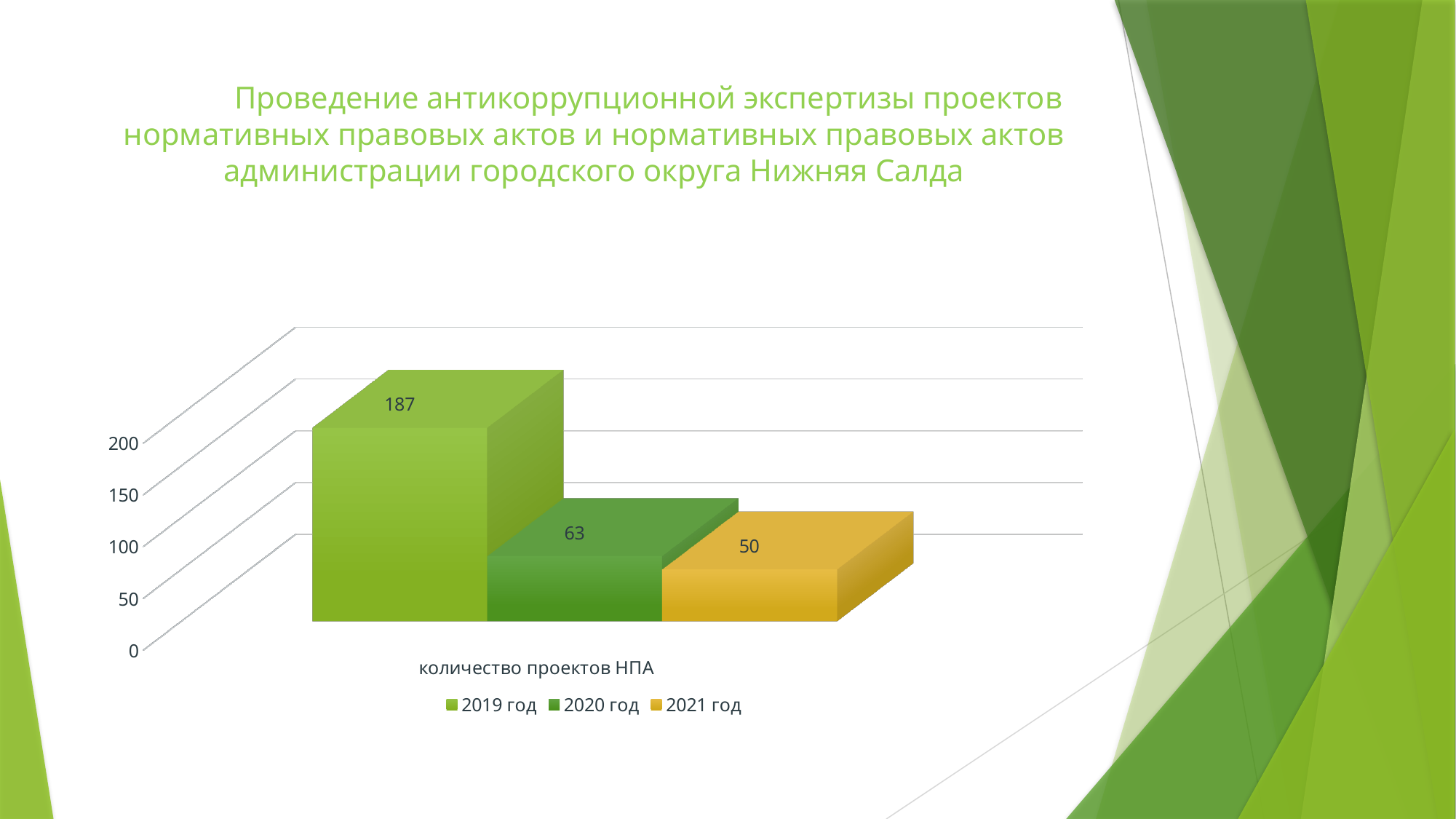
What is the difference between the values for 2020 год and 2021 год? 13 What is the value for 2021 год (количество проектов НПА)? 50 Is the value for 2019 год greater or less than 150? greater What is the value for 2020 год (количество проектов НПА)? 63 What is the difference between the values for 2019 год and 2020 год? 124 How many series does the legend list? 3 What is the value for 2019 год (количество проектов НПА)? 187 Which is larger, the value for 2020 год or the value for 2021 год? 2020 год What kind of chart is shown on the slide? bar chart Which year has the highest number of проектов НПА? 2019 год Which year has the lowest number of проектов НПА? 2021 год What is the category label shown on the x axis? количество проектов НПА